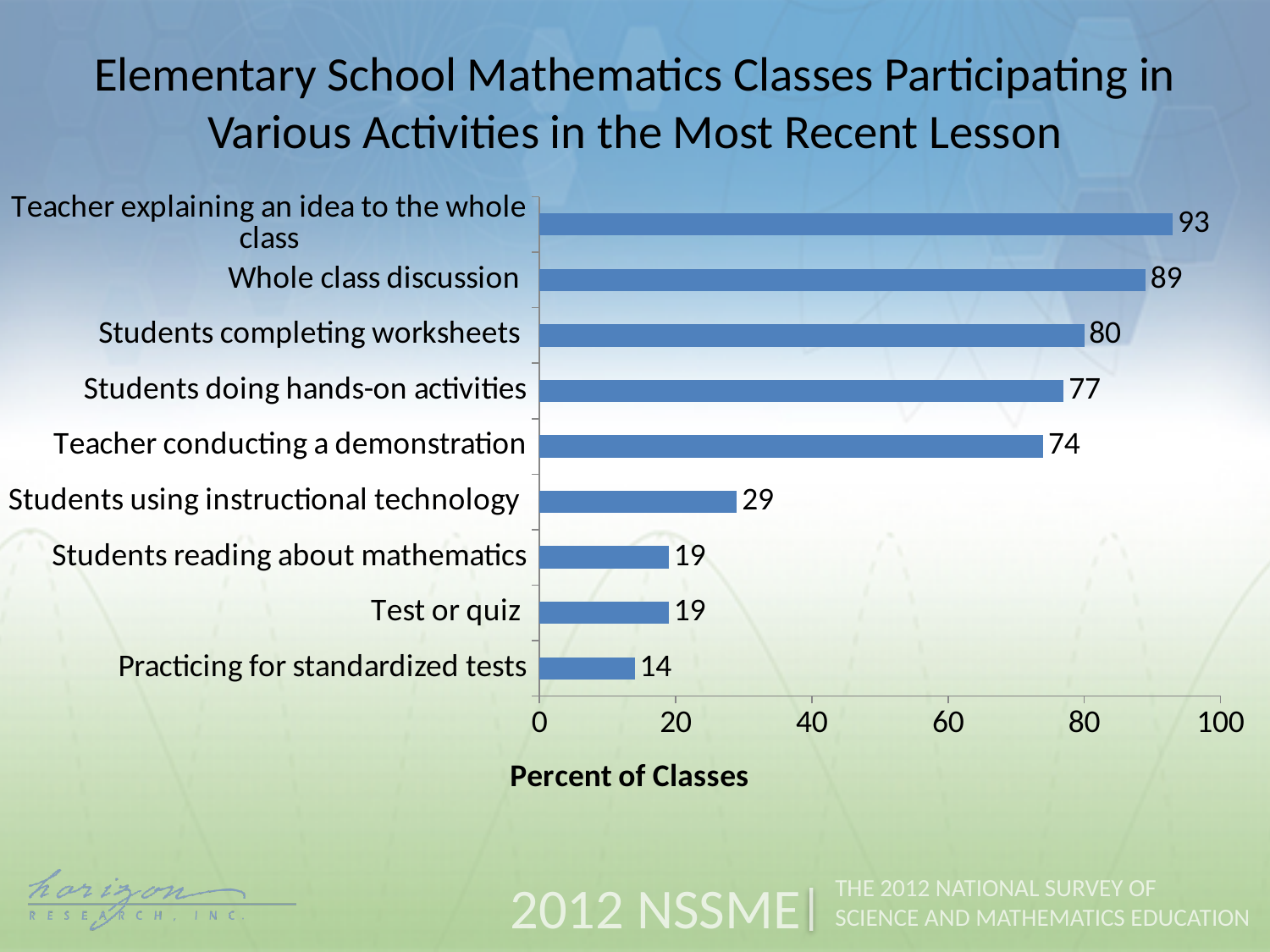
Is the value for Teacher conducting a demonstration greater or less than 60? greater What is the value for Students using instructional technology? 29 What is the difference between the values for Students doing hands-on activities and Students using instructional technology? 48 What is the value for Teacher conducting a demonstration? 74 What kind of chart is shown on the slide? Bar chart Which activity has the highest percent of classes? Teacher explaining an idea to the whole class Which is larger, the value for Students completing worksheets or the value for Students doing hands-on activities? Students completing worksheets What percent of classes had the teacher explaining an idea to the whole class? 93 Which activity has the lowest percent of classes? Practicing for standardized tests How many activities are shown in the chart? 9 What is the label of the horizontal axis? Percent of Classes What is the difference between the values for Whole class discussion and Students completing worksheets? 9